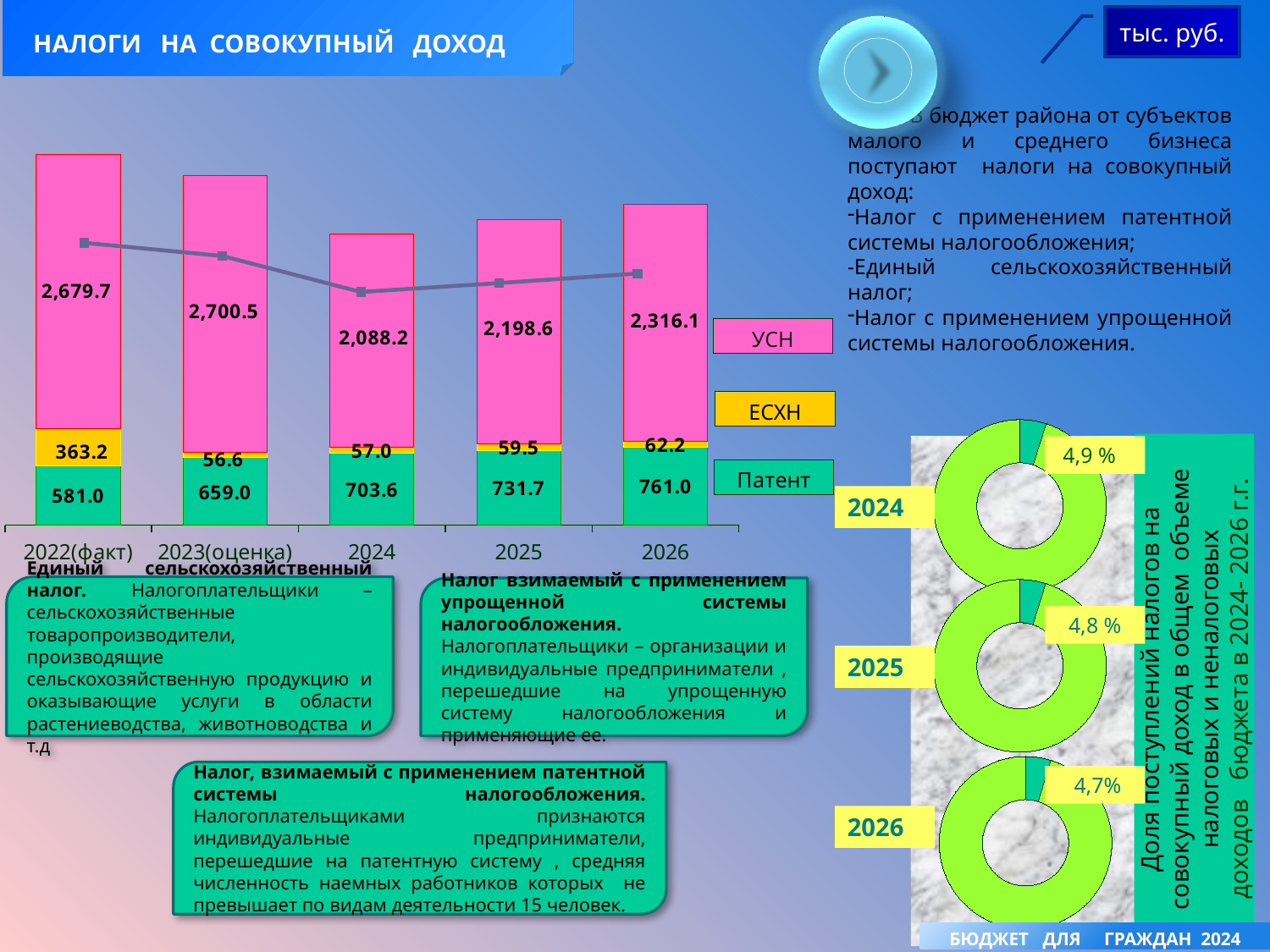
In the stacked bar chart on the left, which is larger: the УСН value for 2023(оценка) or for 2022(факт)? 2023(оценка) In the stacked bar chart on the left, what is the УСН value for 2024? 2,088.2 In the stacked bar chart on the left, what is the total of the stacked bar for 2024? 2,848.8 In the stacked bar chart on the left, what is the Патент value for 2022(факт)? 581.0 In the stacked bar chart on the left, what is the ЕСХН value for 2026? 62.2 In the stacked bar chart on the left, which year has the lowest УСН value? 2024 In the stacked bar chart on the left, how many years are shown on the x axis? 5 In the stacked bar chart on the left, how many series does the legend list? 3 In the donut charts on the right, what share is shown for 2025? 4,8 % In the stacked bar chart on the left, which year has the highest ЕСХН value? 2022(факт) In the stacked bar chart on the left, do the Патент values rise or fall from 2022(факт) to 2026? rise In the stacked bar chart on the left, what is the difference between the Патент values for 2026 and 2025? 29.3